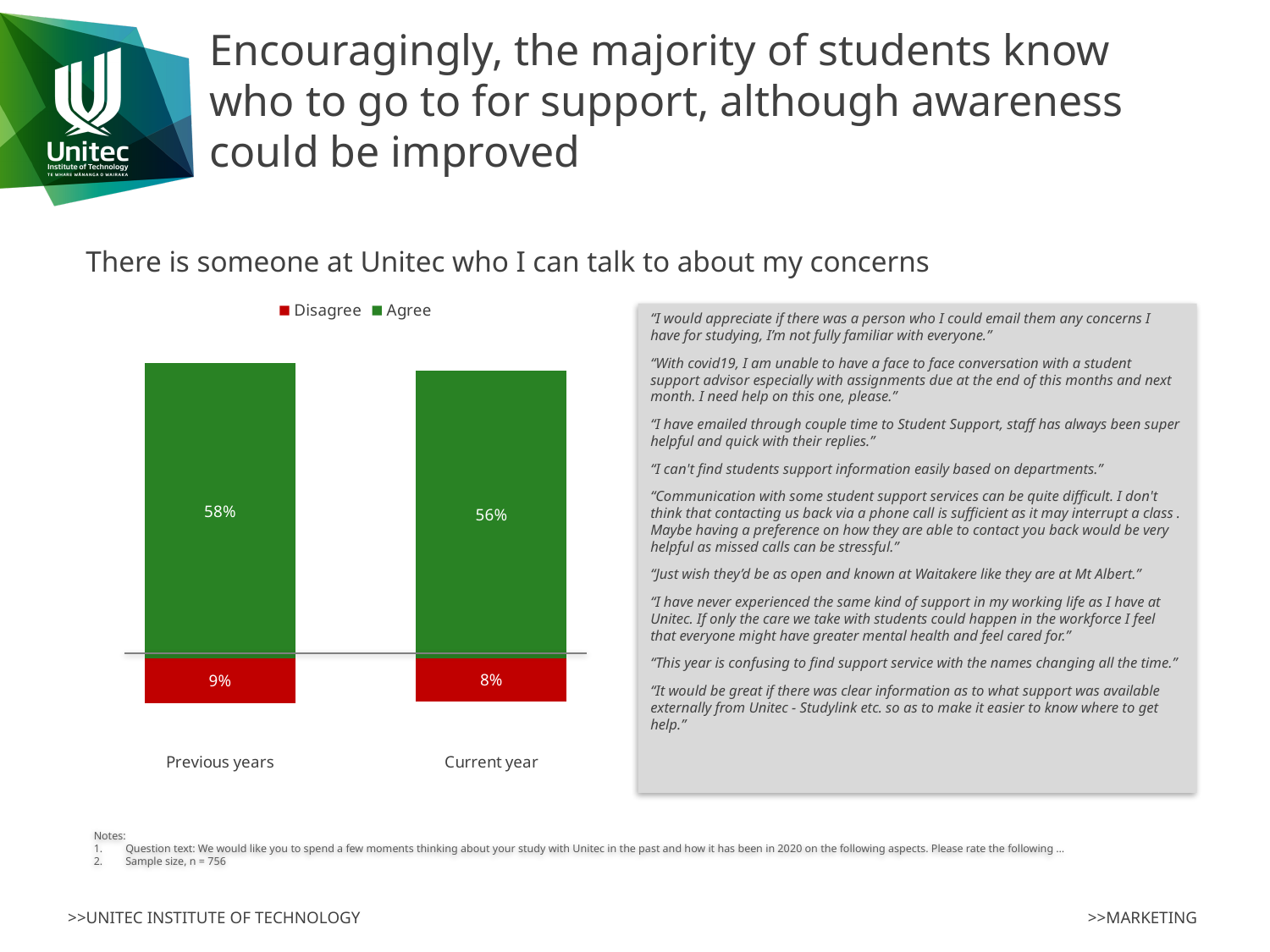
What is the Agree value for Current year? 56% What is the Disagree value for Previous years? 9% What is the Agree value for Previous years? 58% What is the Disagree value for Current year? 8% How many categories are shown on the x axis? 2 Which category has the lower Disagree value? Current year What is the difference between the Disagree values for Previous years and Current year? 1% What is the difference between the Agree values for Previous years and Current year? 2% Which category has the higher Agree value, Previous years or Current year? Previous years How many series does the legend list? 2 What kind of chart is shown? Bar chart Which colour represents the Agree series? Green